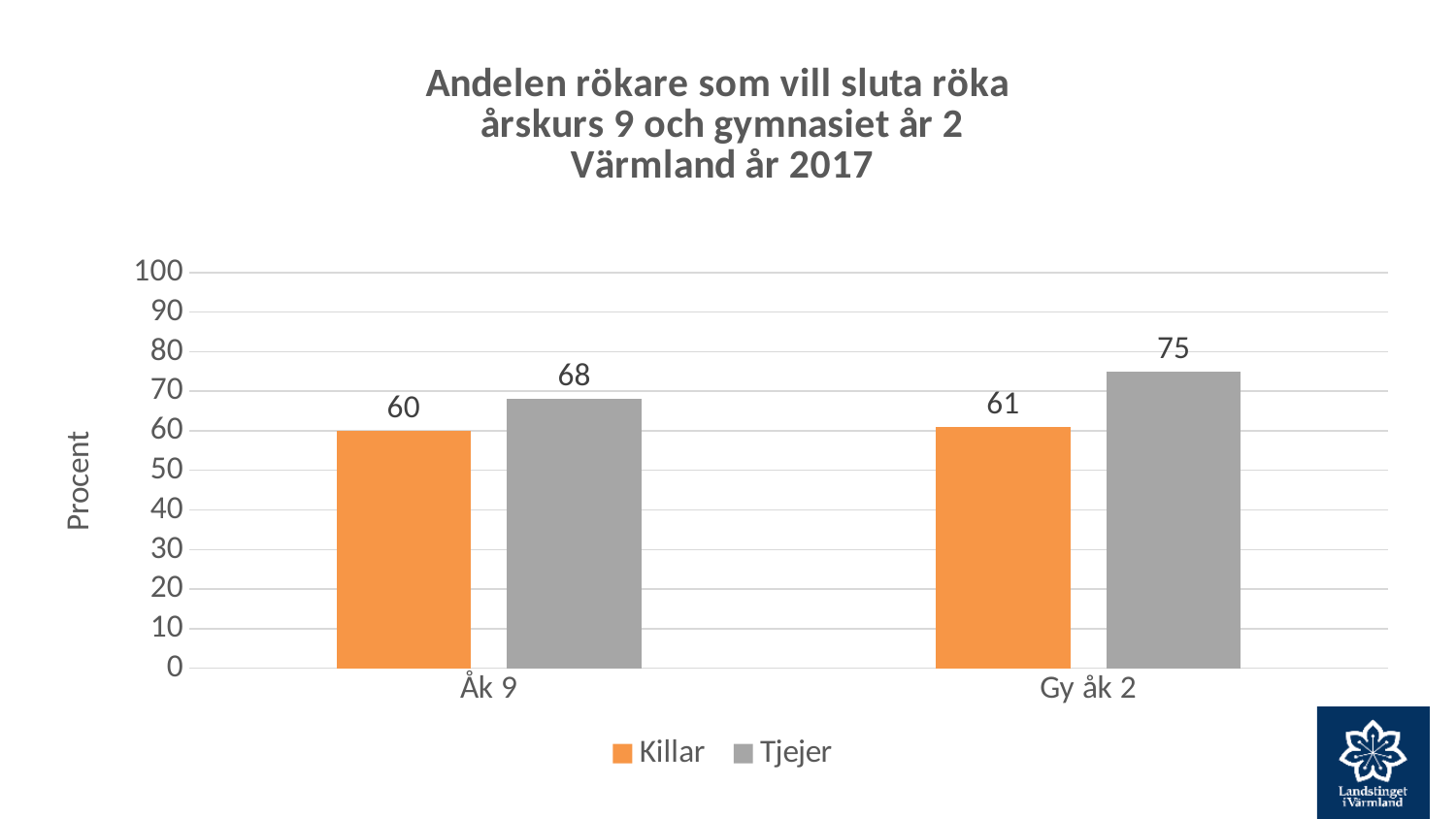
What is the difference between Tjejer and Killar in Gy åk 2? 14 Which category has the highest value for Tjejer? Gy åk 2 Which is larger in Åk 9, Killar or Tjejer? Tjejer Which bar has the lowest value on the chart? Killar, Åk 9 How many series does the legend list? 2 What is the difference between Tjejer in Gy åk 2 and Tjejer in Åk 9? 7 What is the label of the y axis? Procent What kind of chart is shown on the slide? Bar chart What is the value for Tjejer in Gy åk 2? 75 What is the value for Tjejer in Åk 9? 68 What is the value for Killar in Gy åk 2? 61 What is the value for Killar in Åk 9? 60